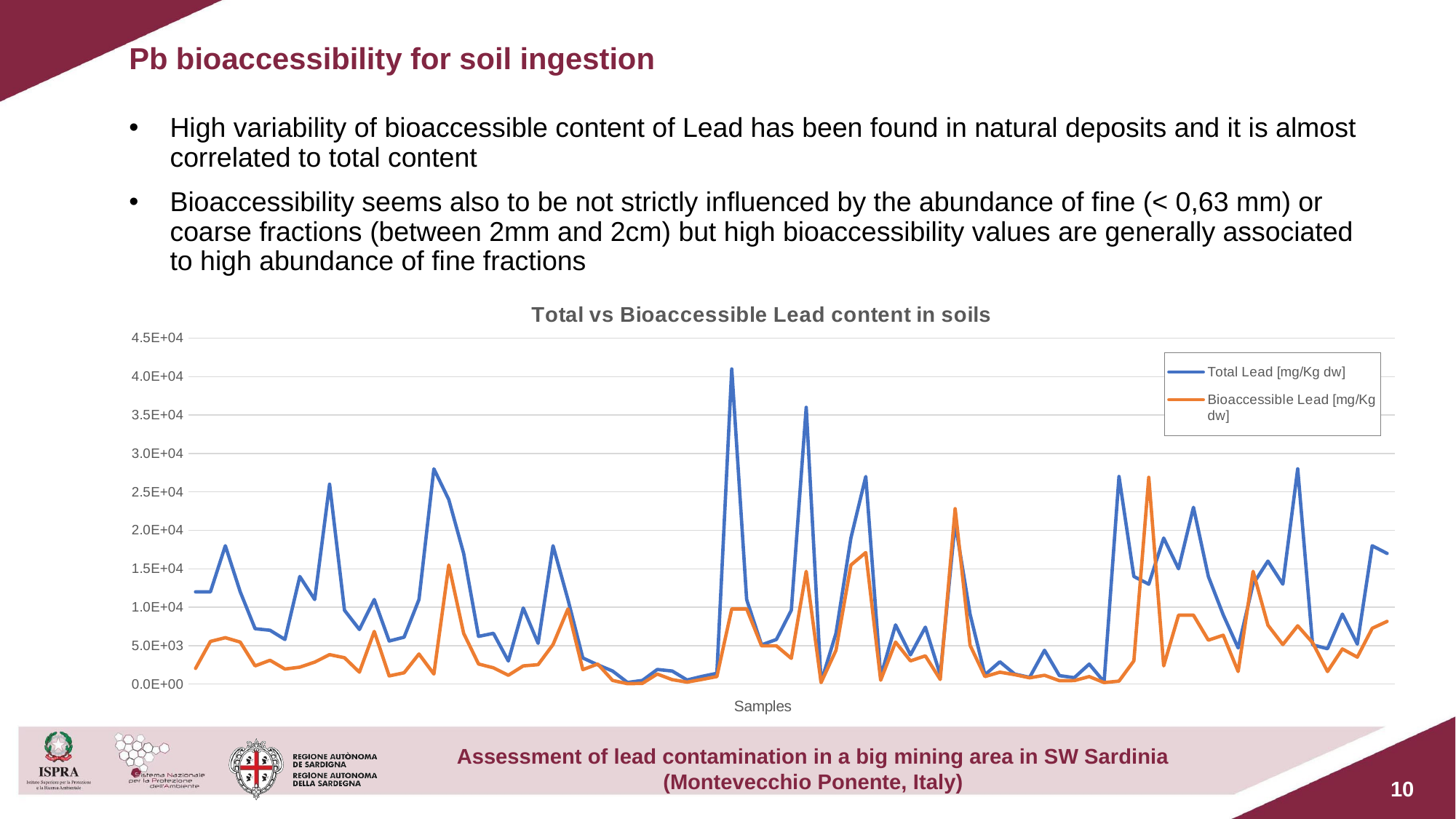
Is the highest value of the Bioaccessible Lead series greater or less than 3.0E+04? less Which series reaches the higher peak value in the chart, Total Lead or Bioaccessible Lead? Total Lead [mg/Kg dw] Is the highest value of the Total Lead series greater or less than 4.0E+04? greater Is the highest value of the Total Lead series greater or less than 4.5E+04? less Which series is drawn in orange in the chart? Bioaccessible Lead [mg/Kg dw] What is the title of the chart? Total vs Bioaccessible Lead content in soils Which series generally lies above the other across the samples in the chart? Total Lead [mg/Kg dw] How many series does the legend of the chart list? 2 What kind of chart is shown on the slide? Line chart